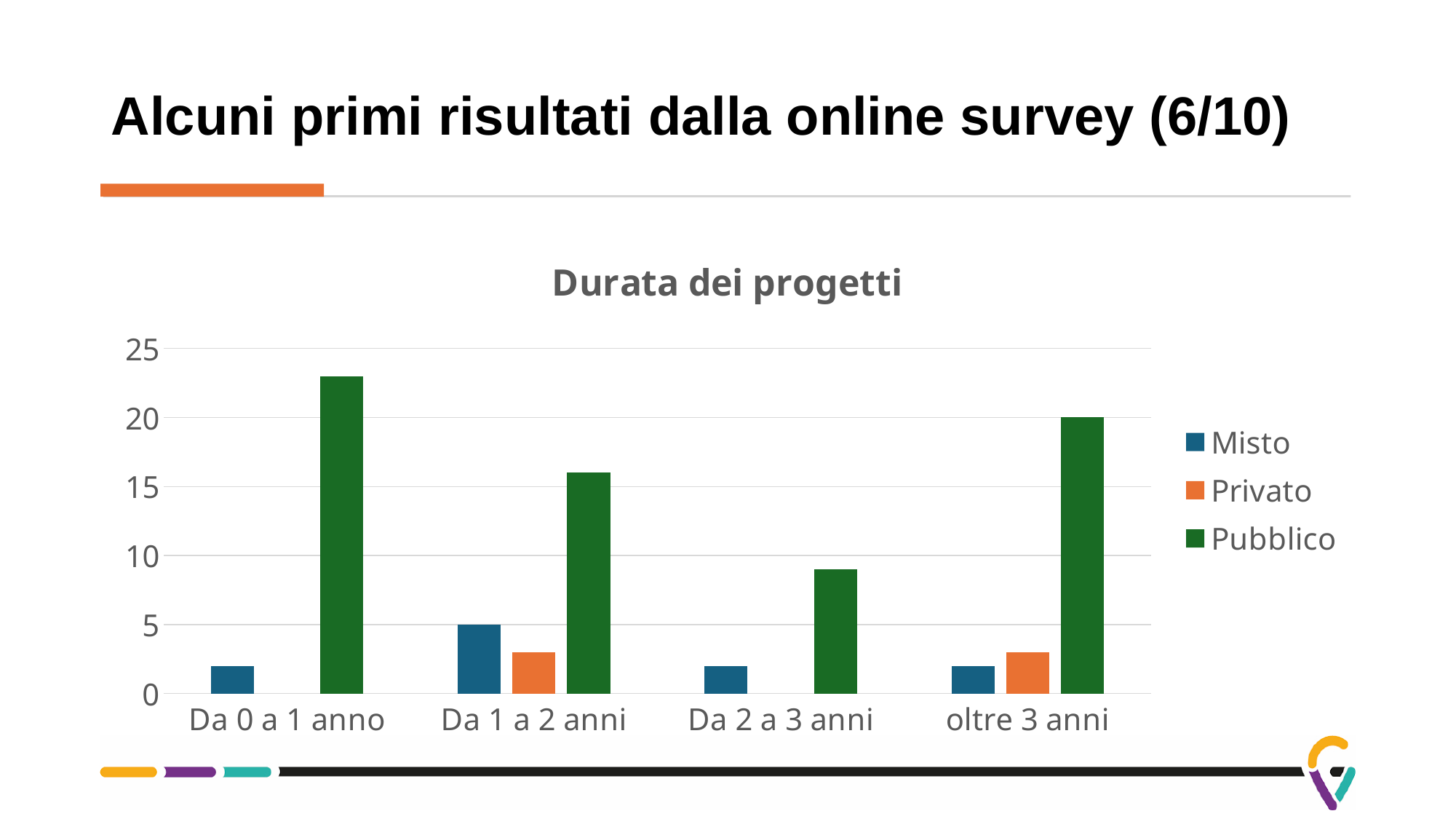
Is the Pubblico value for Da 0 a 1 anno greater or less than 20? greater Which is larger for Da 1 a 2 anni, the Misto value or the Privato value? Misto Which series is shown in green? Pubblico What kind of chart is shown on the slide? bar chart Which category has the lowest Pubblico value? Da 2 a 3 anni How many categories are shown on the x axis? 4 Is the Pubblico value for Da 2 a 3 anni greater or less than 10? less Which category has the highest Misto value? Da 1 a 2 anni Which category has the highest Pubblico value? Da 0 a 1 anno Is the Pubblico value for Da 1 a 2 anni greater or less than 15? greater What is the title of the chart? Durata dei progetti How many series does the legend list? 3